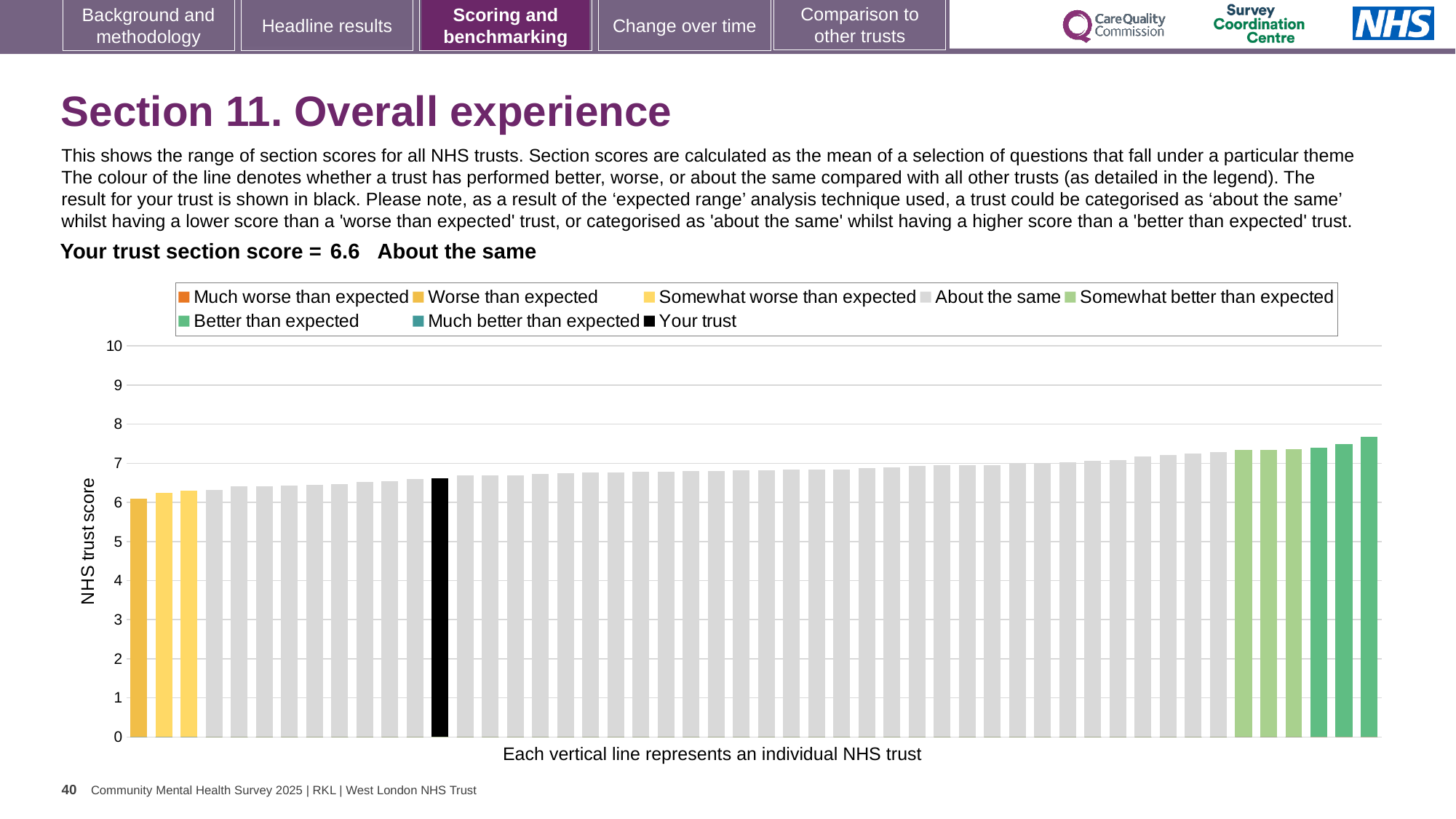
Is the value of the black 'Your trust' bar greater or less than 7? less Is the value of the black 'Your trust' bar greater or less than 6? greater What kind of chart is shown on the slide? bar chart How many entries does the chart legend list? 8 Which category is your trust's section score placed in? About the same What is the label on the vertical axis of the chart? NHS trust score Is the value of the shortest bar in the chart greater or less than 7? less What is the section score for your trust shown on the slide? 6.6 What is the highest tick value shown on the vertical axis? 10 Do the bar values rise or fall from left to right across the chart? rise